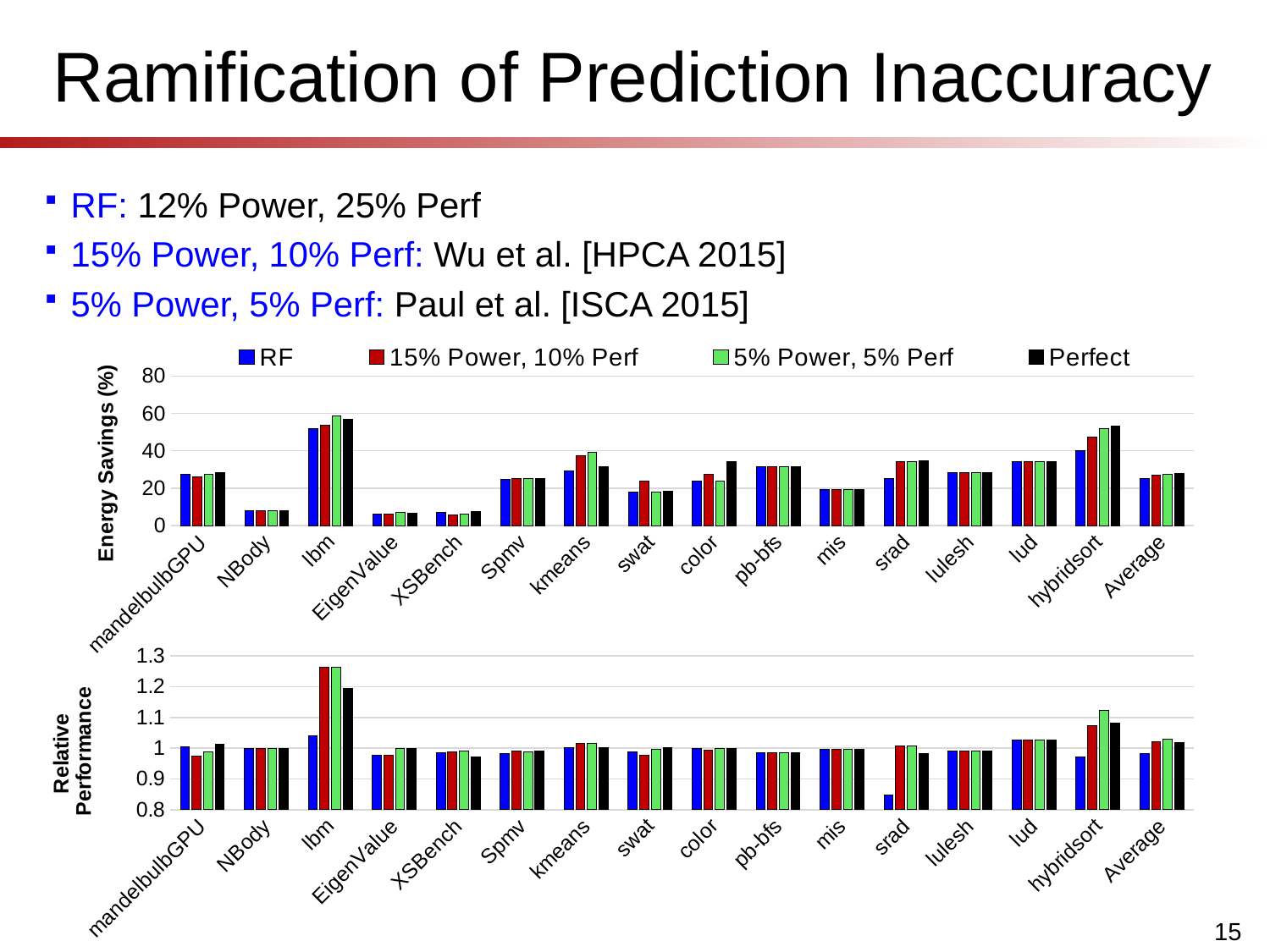
In the bottom chart (Relative Performance), which is larger for the RF series: lbm or hybridsort? lbm In the top chart (Energy Savings), is the RF value for NBody greater or less than 20? less In the bottom chart (Relative Performance), is the RF value for srad greater or less than 0.9? less What kind of chart is the top chart (Energy Savings)? bar chart In the top chart (Energy Savings), is the RF value for lbm greater or less than 40? greater How many series does the legend of the top chart list? 4 In the top chart (Energy Savings), which is larger for the RF series: lbm or NBody? lbm What is the y-axis label of the top chart? Energy Savings (%) How many categories are shown on the x axis of the bottom chart (Relative Performance)? 16 In the bottom chart (Relative Performance), which category has the highest value for the 15% Power, 10% Perf series? lbm In the top chart (Energy Savings), which category has the highest energy savings for the RF series? lbm